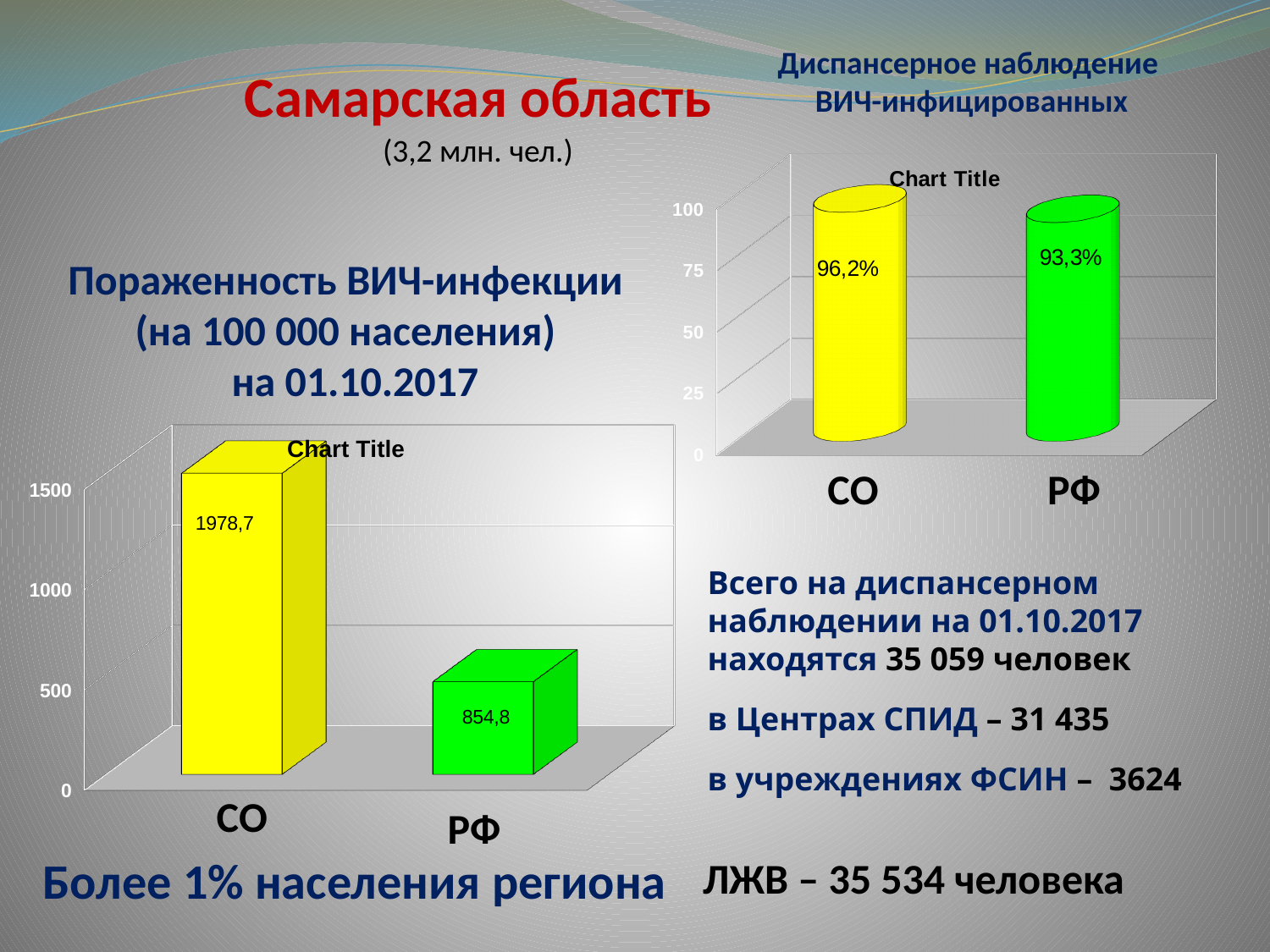
In the right chart (Диспансерное наблюдение ВИЧ-инфицированных), by how many percentage points does СО exceed РФ? 2,9 In the right chart (Диспансерное наблюдение ВИЧ-инфицированных), is the value for РФ greater or less than 75? greater In the left chart (Пораженность ВИЧ-инфекции), what is the difference between the values for СО and РФ? 1123,9 In the left chart (Пораженность ВИЧ-инфекции), what is the value for СО? 1978,7 In the left chart (Пораженность ВИЧ-инфекции), which category has the higher value? СО In the right chart (Диспансерное наблюдение ВИЧ-инфицированных), what is the value for СО? 96,2% In the right chart (Диспансерное наблюдение ВИЧ-инфицированных), which category has the lower value? РФ In the left chart (Пораженность ВИЧ-инфекции), what colour is the bar for РФ? Green In the left chart (Пораженность ВИЧ-инфекции), how many categories are shown? 2 What kind of chart is the left chart (Пораженность ВИЧ-инфекции)? Bar chart In the right chart (Диспансерное наблюдение ВИЧ-инфицированных), what is the value for РФ? 93,3% In the left chart (Пораженность ВИЧ-инфекции), what is the value for РФ? 854,8